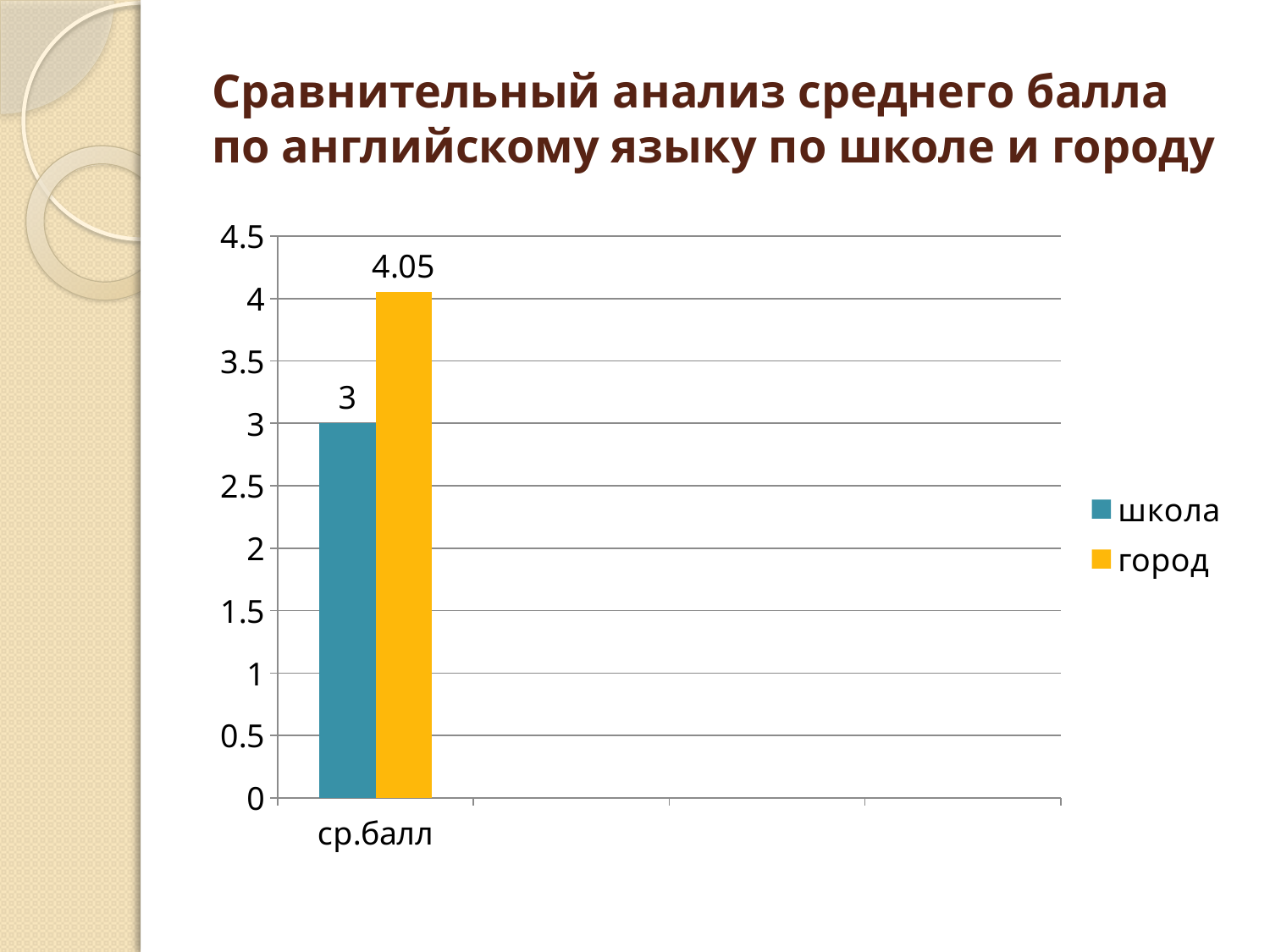
How many series does the legend list? 2 Which series has the higher value for ср.балл, школа or город? город What is the difference between the город and школа values for ср.балл? 1.05 What kind of chart is shown on the slide? bar chart How many categories are shown on the x axis? 1 What is the value for школа in the ср.балл category? 3 Which series has the lowest value on the chart? школа What is the label of the category on the x axis? ср.балл Which series is shown in yellow? город Is the value for школа greater or less than 3.5? less What is the value for город in the ср.балл category? 4.05 Is the value for город greater or less than 4? greater